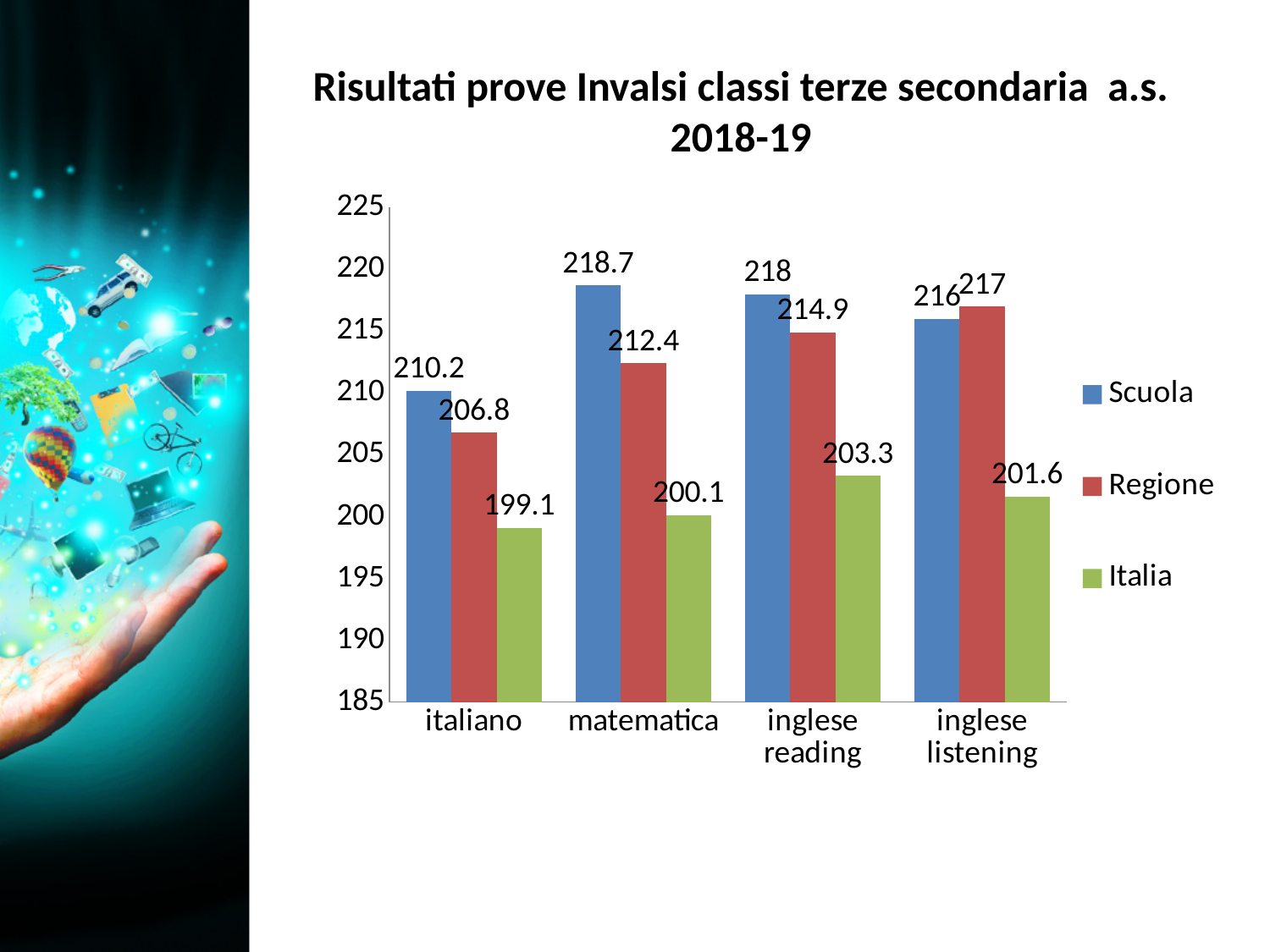
What kind of chart is shown on the slide? bar chart Is the Italia value for inglese listening greater or less than 205? less What is the difference between the Scuola and Italia values for matematica? 18.6 How many series does the legend list? 3 Which category has the highest Scuola value? matematica What is the Scuola value for matematica? 218.7 How many categories are shown on the x axis? 4 What is the title of the chart? Risultati prove Invalsi classi terze secondaria a.s. 2018-19 Which category has the lowest Italia value? italiano For inglese listening, which is larger: the Scuola value or the Regione value? Regione What is the Regione value for italiano? 206.8 What is the Italia value for inglese reading? 203.3